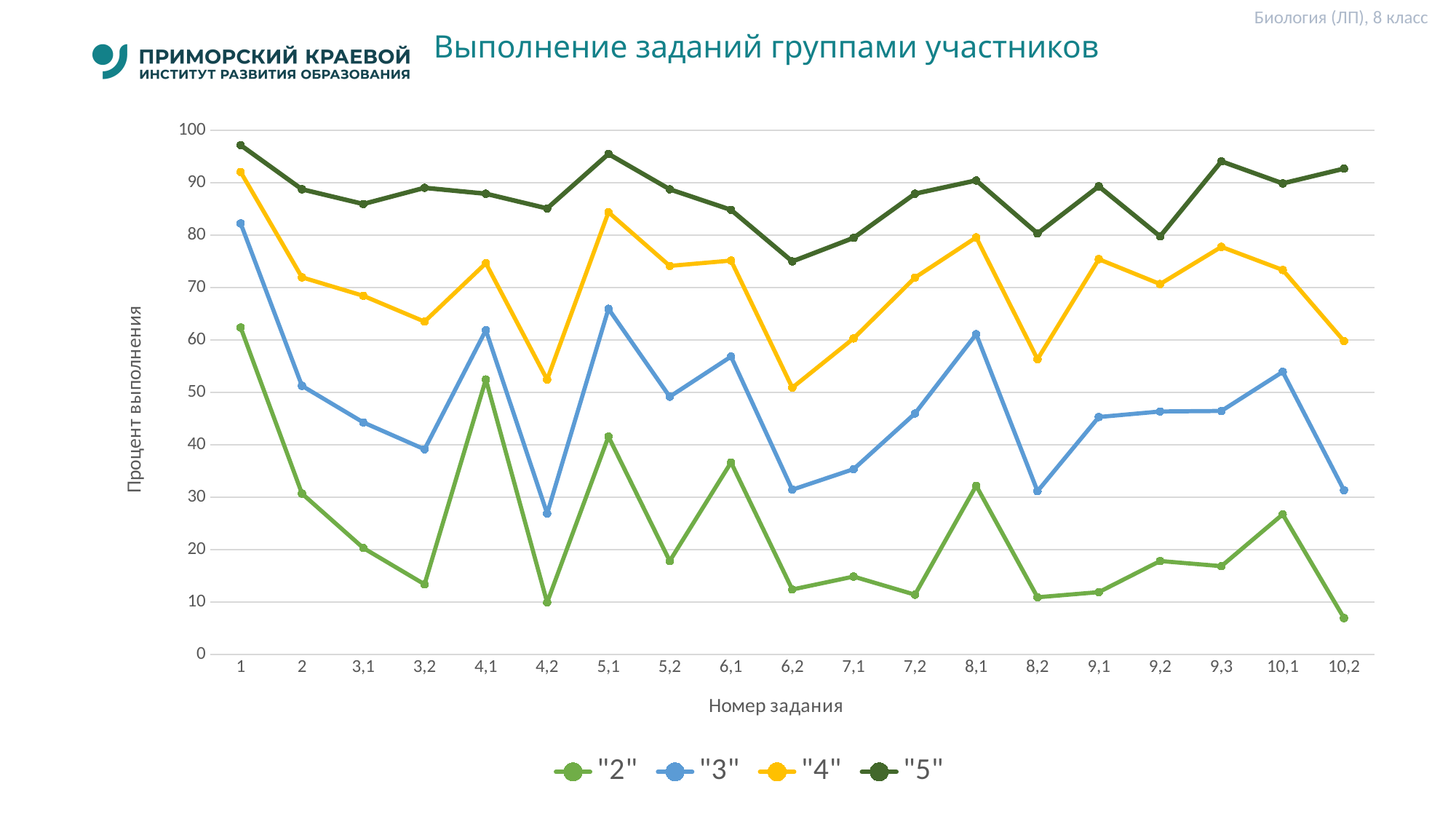
What kind of chart is shown on the slide? line chart Is the value for series "2" at task 4,2 greater or less than 20? less Is the value for series "5" at task 6,2 greater or less than 80? less For series "5", at which task number is the value lowest? 6,2 Is the value for series "3" at task 5,1 greater or less than 60? greater How many series does the legend list? 4 For series "2", which is larger: the value at task 4,1 or at task 5,1? 4,1 How many task numbers are shown along the x axis? 19 Does the value for series "3" rise or fall from task 1 to task 3,2? fall What is the title of the y axis? Процент выполнения For series "2", at which task number is the value highest? 1 For series "4", at which task number is the value highest? 1